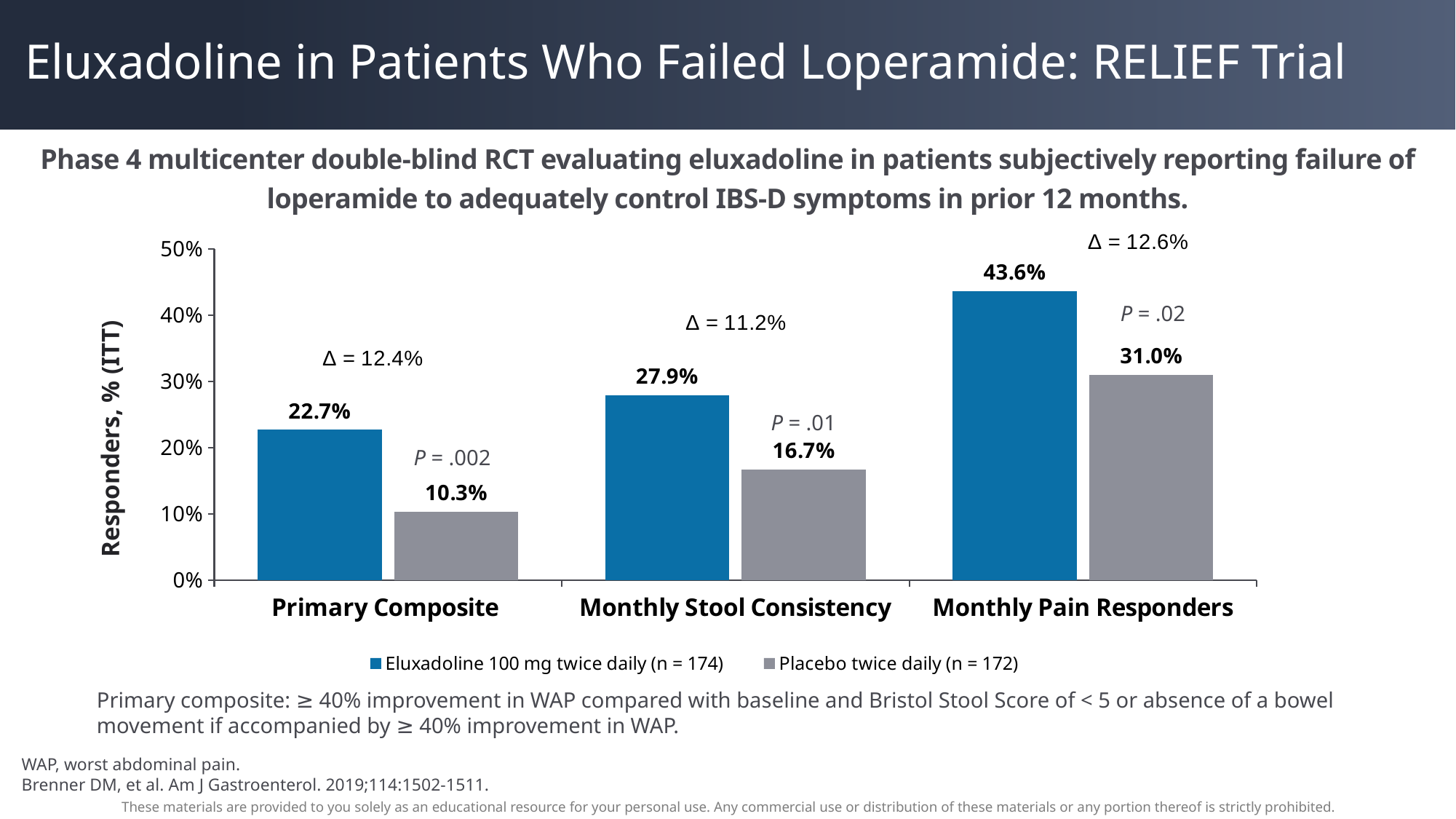
Which category has the lowest responder rate for Placebo twice daily? Primary Composite What is the responder rate for Eluxadoline 100 mg twice daily in the Primary Composite category? 22.7% How many series does the chart legend list? 2 What is the responder rate for Placebo twice daily in the Monthly Pain Responders category? 31.0% Which is larger in the Primary Composite category: the Eluxadoline responder rate or the Placebo responder rate? Eluxadoline 100 mg twice daily What is the difference between the Eluxadoline and Placebo responder rates in the Monthly Stool Consistency category? 11.2% What is the responder rate for Placebo twice daily in the Monthly Stool Consistency category? 16.7% What kind of chart is shown on the slide? Bar chart Which category has the highest responder rate for Eluxadoline 100 mg twice daily? Monthly Pain Responders What is the label of the y axis of the chart? Responders, % (ITT) How many categories are shown on the x axis of the chart? 3 Is the Eluxadoline responder rate for Monthly Pain Responders greater or less than 40%? greater